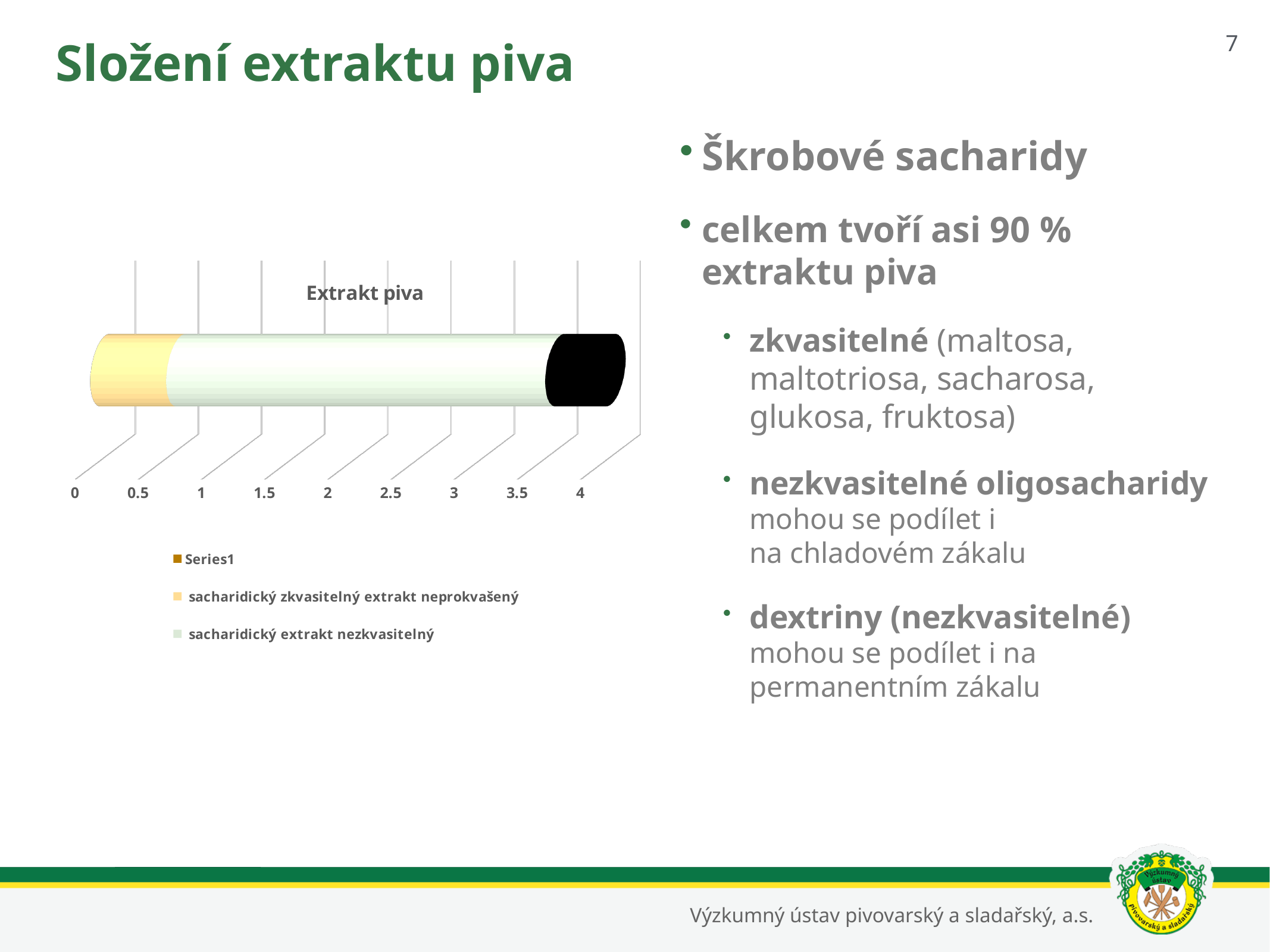
What is the title of the chart? Extrakt piva Which segment is larger: 'sacharidický zkvasitelný extrakt neprokvašený' or 'sacharidický extrakt nezkvasitelný'? sacharidický extrakt nezkvasitelný Is the total length of the stacked bar greater or less than 3? greater What is the highest value shown on the chart's axis? 4 What kind of chart is shown on the slide? bar chart How many bars are plotted in the chart? 1 Which legend entry represents the largest segment of the bar? sacharidický extrakt nezkvasitelný How many series does the chart legend list? 3 Is the value of the 'sacharidický zkvasitelný extrakt neprokvašený' segment greater or less than 1? less